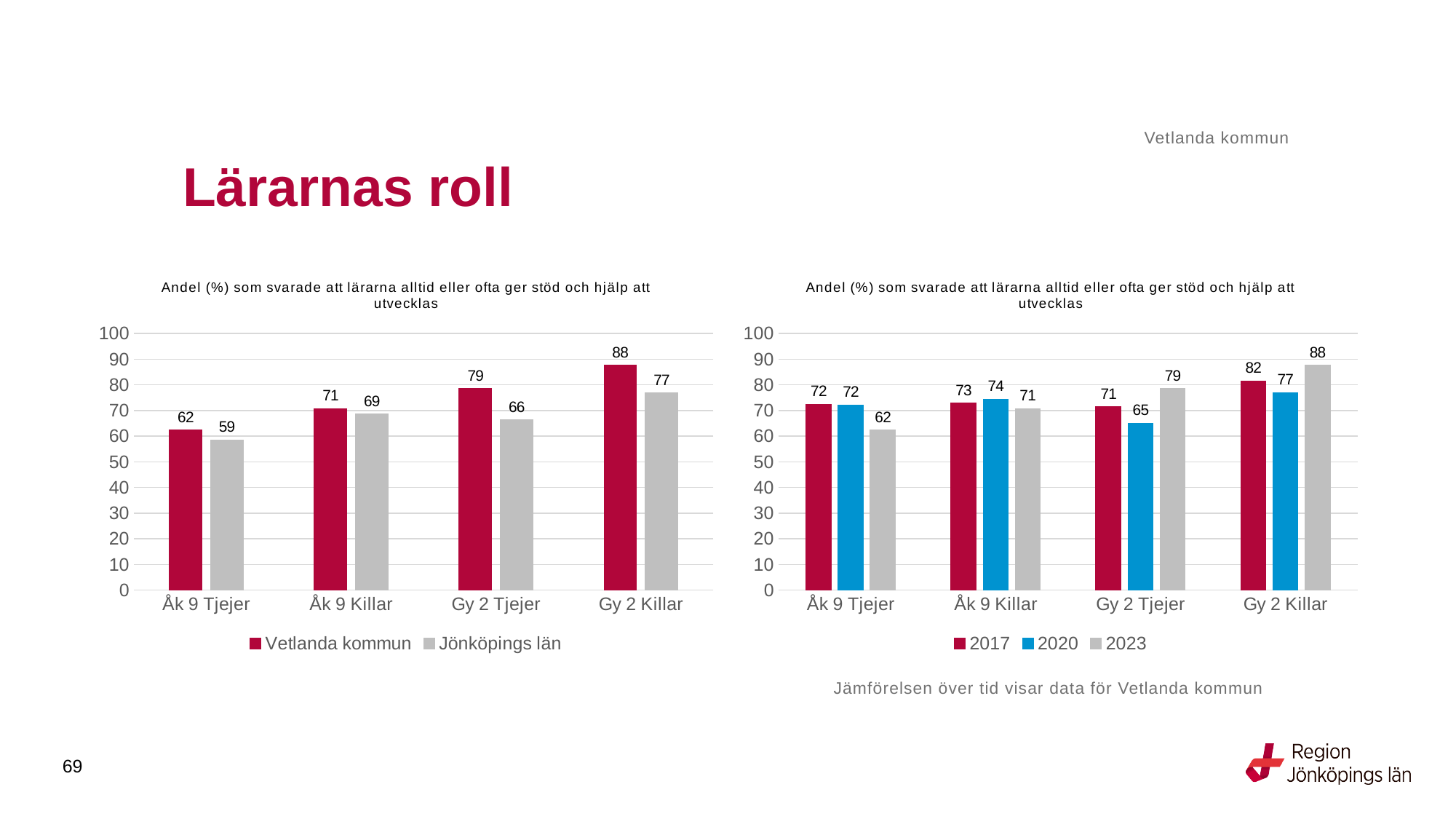
In the left chart, how many series does the legend list? 2 In the right chart, what is the value for 2020 for Gy 2 Tjejer? 65 In the left chart, what is the value for Vetlanda kommun for Gy 2 Killar? 88 In the right chart, what is the difference between 2017 and 2023 for Gy 2 Killar? 6 In the right chart, which category has the highest value for 2023? Gy 2 Killar What kind of chart is the right chart? Bar chart In the right chart, how many categories are shown on the x axis? 4 In the left chart, which category has the lowest value for Vetlanda kommun? Åk 9 Tjejer In the left chart, what is the difference between Vetlanda kommun and Jönköpings län for Gy 2 Tjejer? 13 In the left chart, which is larger for Åk 9 Killar: Vetlanda kommun or Jönköpings län? Vetlanda kommun In the right chart, what is the value for 2023 for Åk 9 Tjejer? 62 In the left chart, what is the value for Jönköpings län for Åk 9 Tjejer? 59